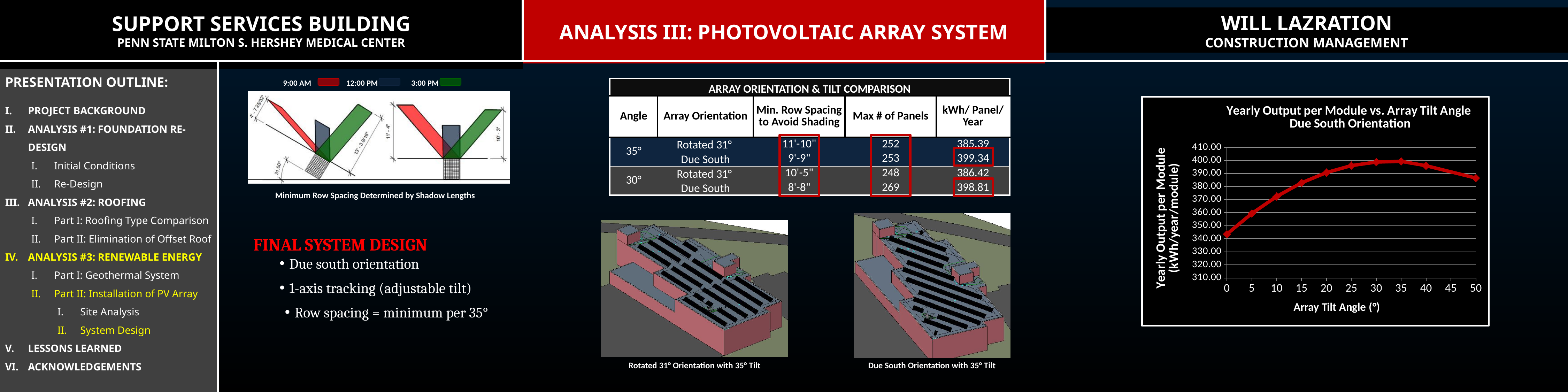
On the "Yearly Output per Module vs. Array Tilt Angle" chart, is the value at a tilt angle of 50 greater or less than 370.00? greater On the "Yearly Output per Module vs. Array Tilt Angle" chart, does the yearly output rise or fall as the tilt angle increases from 0 to 30? rise On the "Yearly Output per Module vs. Array Tilt Angle" chart, which has the higher yearly output: a tilt angle of 0 or a tilt angle of 50? 50 On the "Yearly Output per Module vs. Array Tilt Angle" chart, is the value at a tilt angle of 0 greater or less than 350.00? less On the "Yearly Output per Module vs. Array Tilt Angle" chart, does the yearly output rise or fall as the tilt angle increases from 35 to 50? fall What orientation does the subtitle of the "Yearly Output per Module vs. Array Tilt Angle" chart specify? Due South Orientation On the "Yearly Output per Module vs. Array Tilt Angle" chart, is the value at a tilt angle of 30 greater or less than 390.00? greater On the "Yearly Output per Module vs. Array Tilt Angle" chart, which tilt angle has the lowest yearly output per module? 0 How many data points are plotted on the "Yearly Output per Module vs. Array Tilt Angle" chart? 10 What kind of chart is "Yearly Output per Module vs. Array Tilt Angle"? line chart What is the x-axis label of the "Yearly Output per Module vs. Array Tilt Angle" chart? Array Tilt Angle (°)